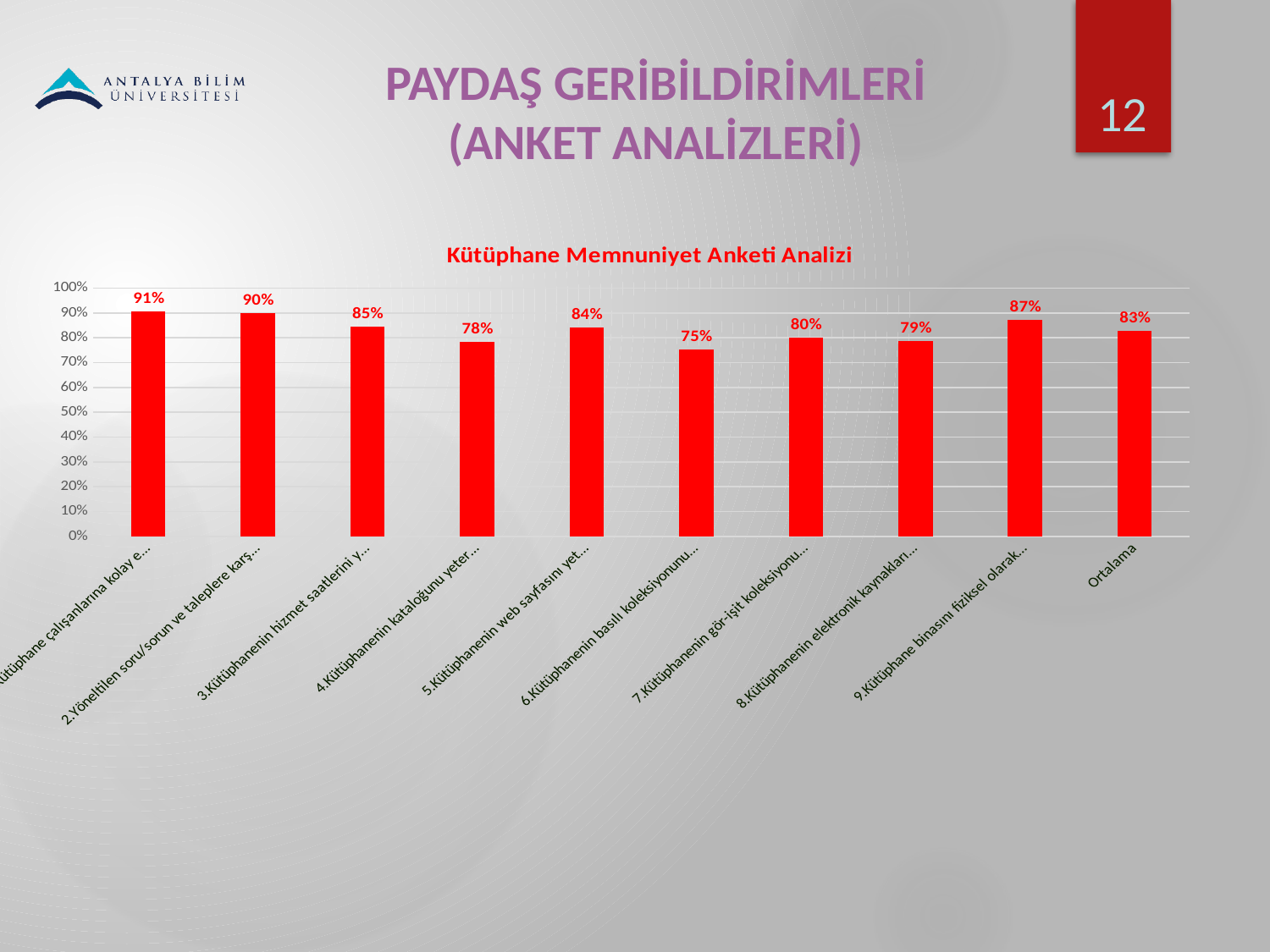
What is the value for the category beginning "6.Kütüphanenin basılı koleksiyonunu"? 75% What is the title of the chart on the slide? Kütüphane Memnuniyet Anketi Analizi What is the highest value shown in the chart? 91% What is the value for the category beginning "9.Kütüphane binasını fiziksel olarak"? 87% How many bars are shown in the chart? 10 What is the difference between the value for the category beginning "4.Kütüphanenin kataloğunu" and the category beginning "5.Kütüphanenin web sayfasını"? 6% Is the value for the category beginning "2.Yöneltilen soru/sorun" greater or less than 80%? greater Which category has the lowest value in the chart? 6.Kütüphanenin basılı koleksiyonunu... What is the value for the category beginning "3.Kütüphanenin hizmet saatlerini"? 85% What kind of chart is shown on the slide? bar chart Which is larger: the value for the category beginning "7.Kütüphanenin gör-işit koleksiyonu" or the category beginning "8.Kütüphanenin elektronik kaynakları"? 7.Kütüphanenin gör-işit koleksiyonu... What is the value for "Ortalama" in the Kütüphane Memnuniyet Anketi Analizi chart? 83%